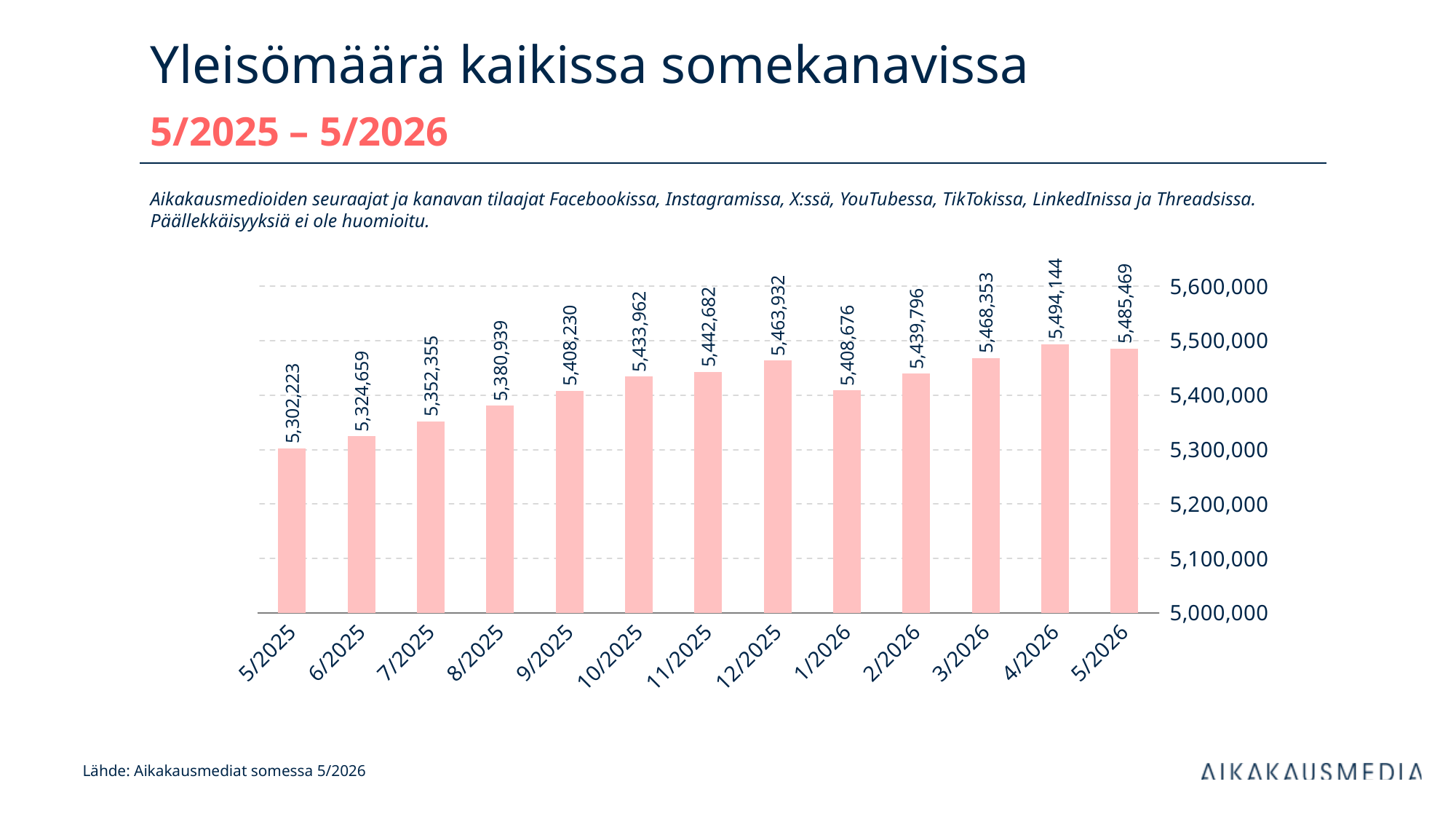
Which month has the highest value? 4/2026 What is the difference between the values for 5/2026 and 5/2025? 183,246 What is the value for 5/2026? 5,485,469 What is the difference between the values for 12/2025 and 1/2026? 55,256 What is the title of the chart on the slide? Yleisömäärä kaikissa somekanavissa What kind of chart is shown on the slide? bar chart What is the value for 12/2025? 5,463,932 How many months are shown on the x axis? 13 Which month has the lowest value? 5/2025 What is the value for 5/2025? 5,302,223 Which is larger, the value for 4/2026 or the value for 5/2026? 4/2026 Is the value for 8/2025 greater or less than 5,400,000? less